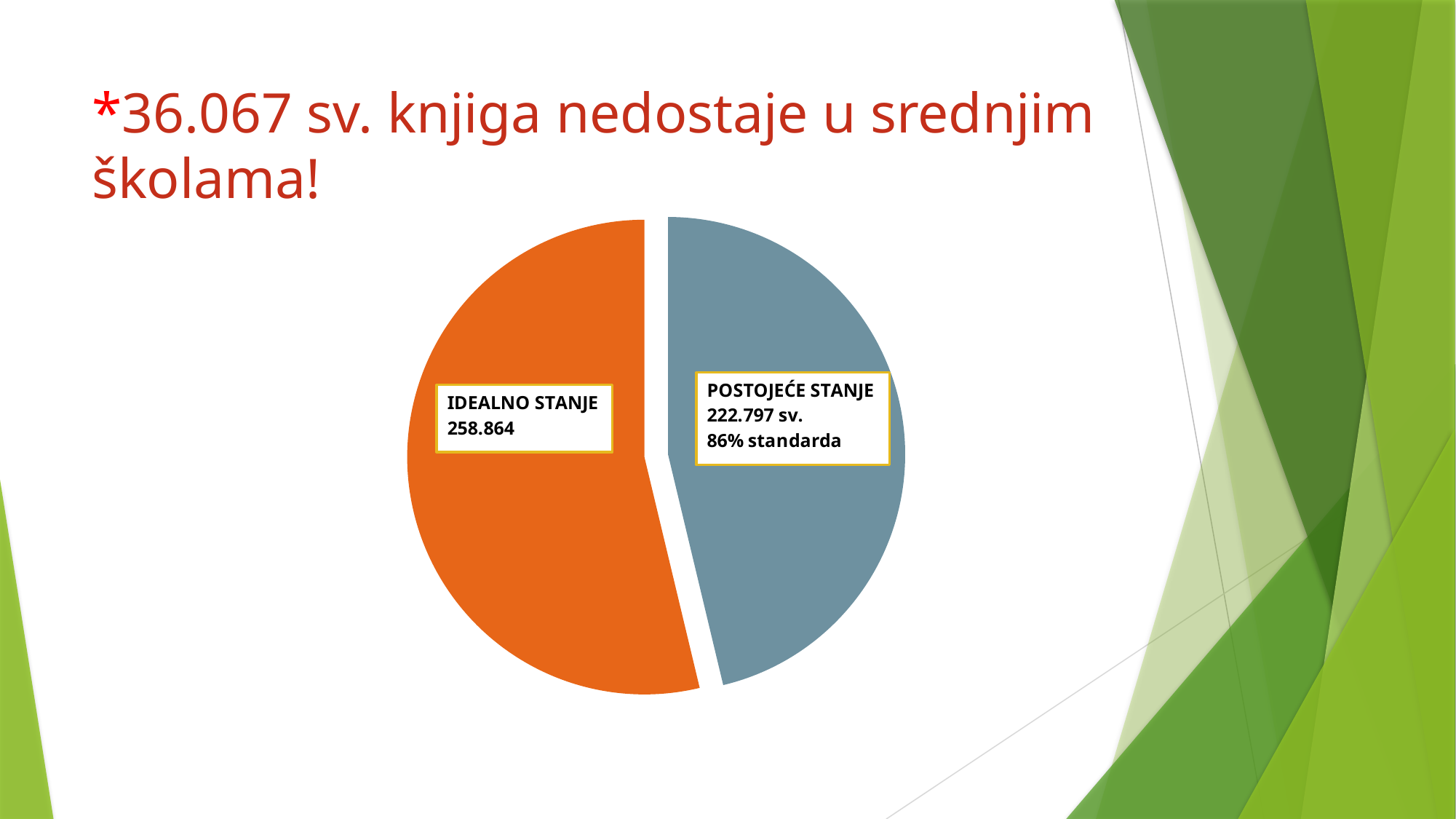
How many slices does the pie chart have? 2 What percentage of the standard does the POSTOJEĆE STANJE label state? 86% standarda Which slice of the pie chart has the smaller value? POSTOJEĆE STANJE Which slice of the pie chart has the larger value? IDEALNO STANJE What is the difference between the IDEALNO STANJE value and the POSTOJEĆE STANJE value? 36.067 What type of chart is shown on the slide? pie chart Is the value for IDEALNO STANJE larger or smaller than the value for POSTOJEĆE STANJE? larger What is the title of the slide above the chart? *36.067 sv. knjiga nedostaje u srednjim školama! What value is shown for the POSTOJEĆE STANJE slice? 222.797 sv. What value is shown for the IDEALNO STANJE slice? 258.864 What colour is the IDEALNO STANJE slice? orange